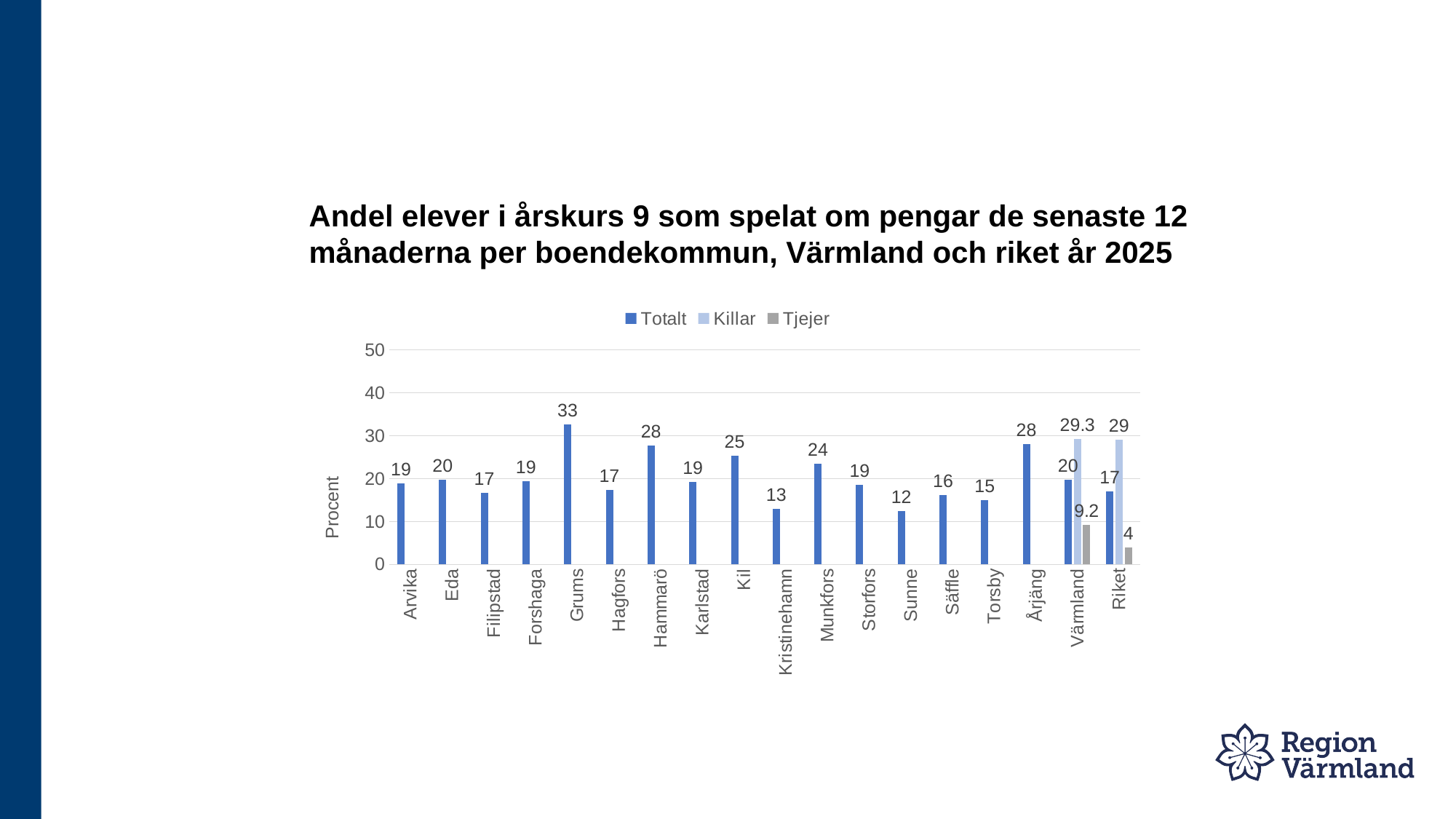
What is the Totalt value for Grums? 33 Which category has the highest Totalt value? Grums How many series does the legend list? 3 How many categories are shown on the x axis? 18 What kind of chart is shown on the slide? Bar chart Which category has the lowest Totalt value? Sunne What is the Killar value for Värmland? 29.3 What is the label on the y axis? Procent Which has a higher Totalt value, Hammarö or Kil? Hammarö What is the difference between the Killar and Tjejer values for Värmland? 20.1 What is the difference between the Totalt values for Grums and Sunne? 21 What is the Tjejer value for Riket? 4